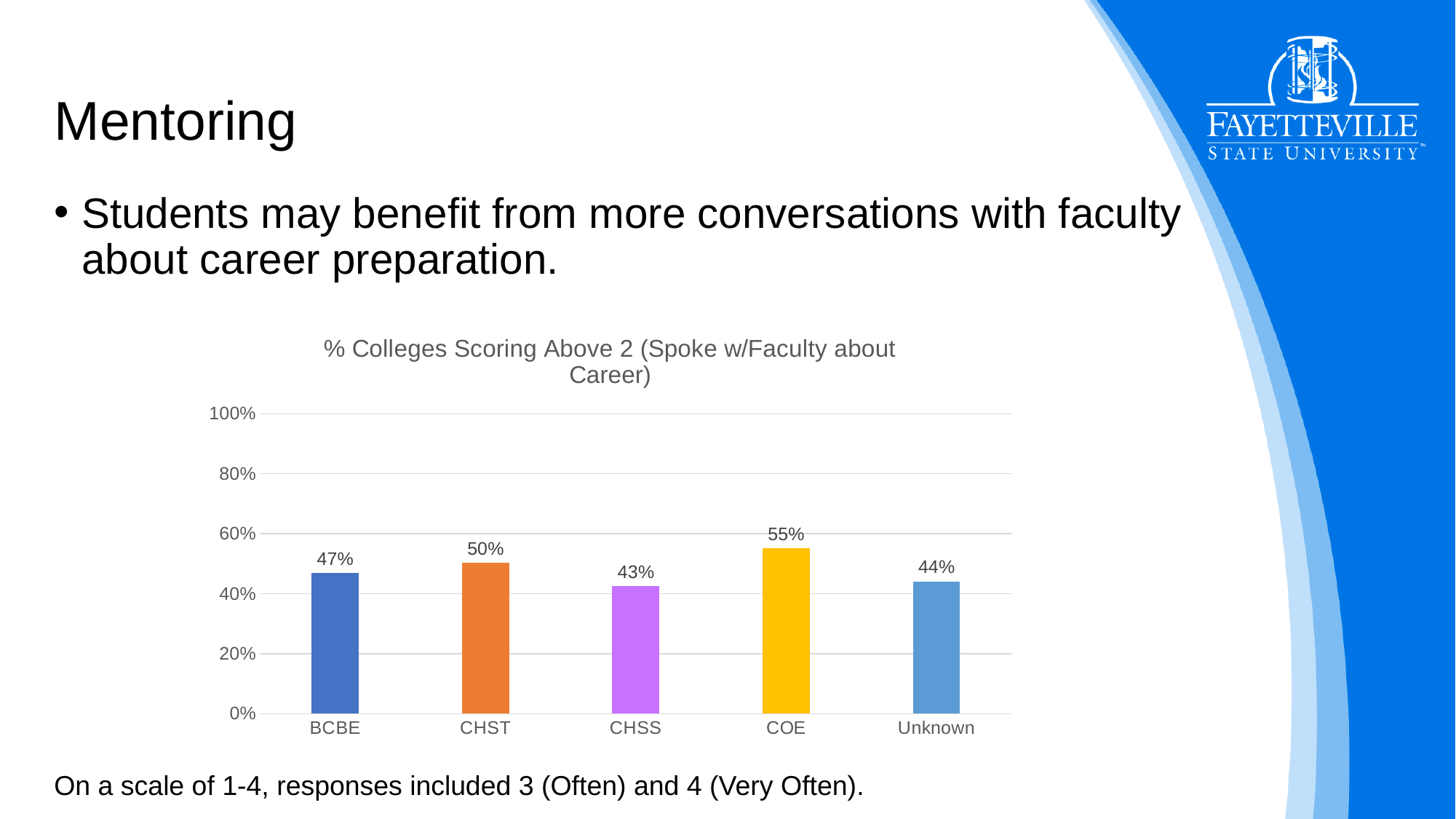
What is the difference between the values for COE and CHSS? 12% Which category has the lowest value? CHSS How many categories are shown on the x axis? 5 What is the value for CHSS? 43% What is the title of the chart? % Colleges Scoring Above 2 (Spoke w/Faculty about Career) What kind of chart is shown on the slide? bar chart What is the difference between the values for CHST and BCBE? 3% What is the value for Unknown? 44% What is the value for COE? 55% Which is larger, the value for BCBE or the value for Unknown? BCBE Is the value for COE greater or less than 60%? less Which category has the highest value? COE